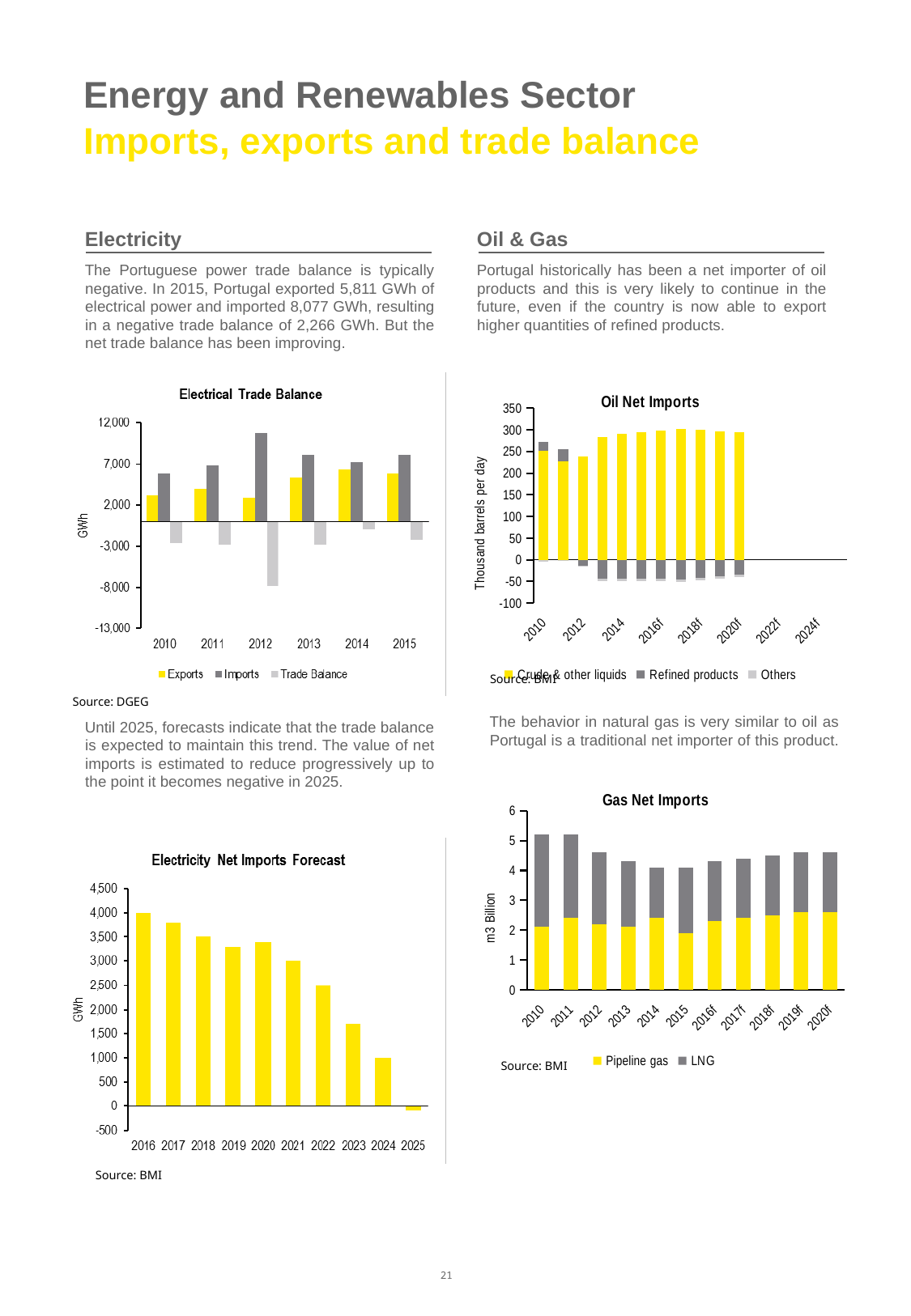
In the Electrical Trade Balance chart, which year has the lowest Trade Balance value? 2012 How many series does the legend of the Electrical Trade Balance chart list? 3 How many series does the legend of the Gas Net Imports chart list? 2 In the Oil Net Imports chart, is the value for Crude & other liquids in 2018f greater or less than 250? greater In the Gas Net Imports chart, is the value for Pipeline gas in 2019f greater or less than 2? greater How many series does the legend of the Oil Net Imports chart list? 3 In the Electrical Trade Balance chart, is the Imports value for 2012 greater or less than 7,000? greater In the Electrical Trade Balance chart, which year has the highest Imports value? 2012 What kind of chart is the Electrical Trade Balance chart? bar chart How many years are shown on the x axis of the Electricity Net Imports Forecast chart? 10 In the Electricity Net Imports Forecast chart, do the values rise or fall from 2016 to 2025? fall